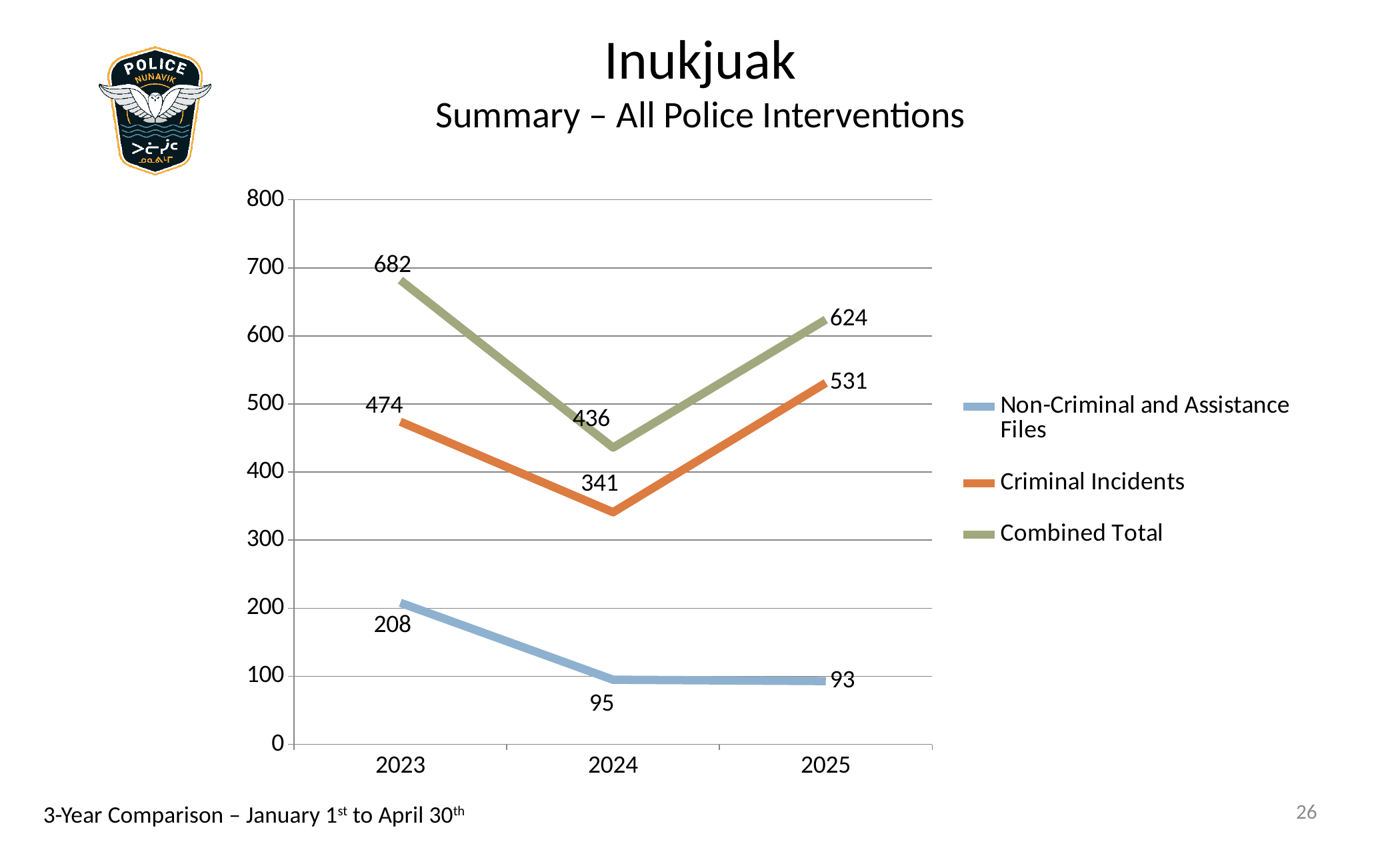
What is the value for Non-Criminal and Assistance Files in 2023? 208 What is the difference between the Combined Total in 2023 and in 2024? 246 What is the difference between Criminal Incidents in 2025 and in 2024? 190 How many years are shown on the x axis? 3 What is the Combined Total for 2025? 624 What kind of chart is shown on the slide? Line chart What is the value for Criminal Incidents in 2024? 341 In which year is the Combined Total highest? 2023 Is the Criminal Incidents value for 2025 greater or less than 500? greater Which is larger: Non-Criminal and Assistance Files in 2024 or in 2025? 2024 How many series does the legend list? 3 In which year is the Criminal Incidents value lowest? 2024